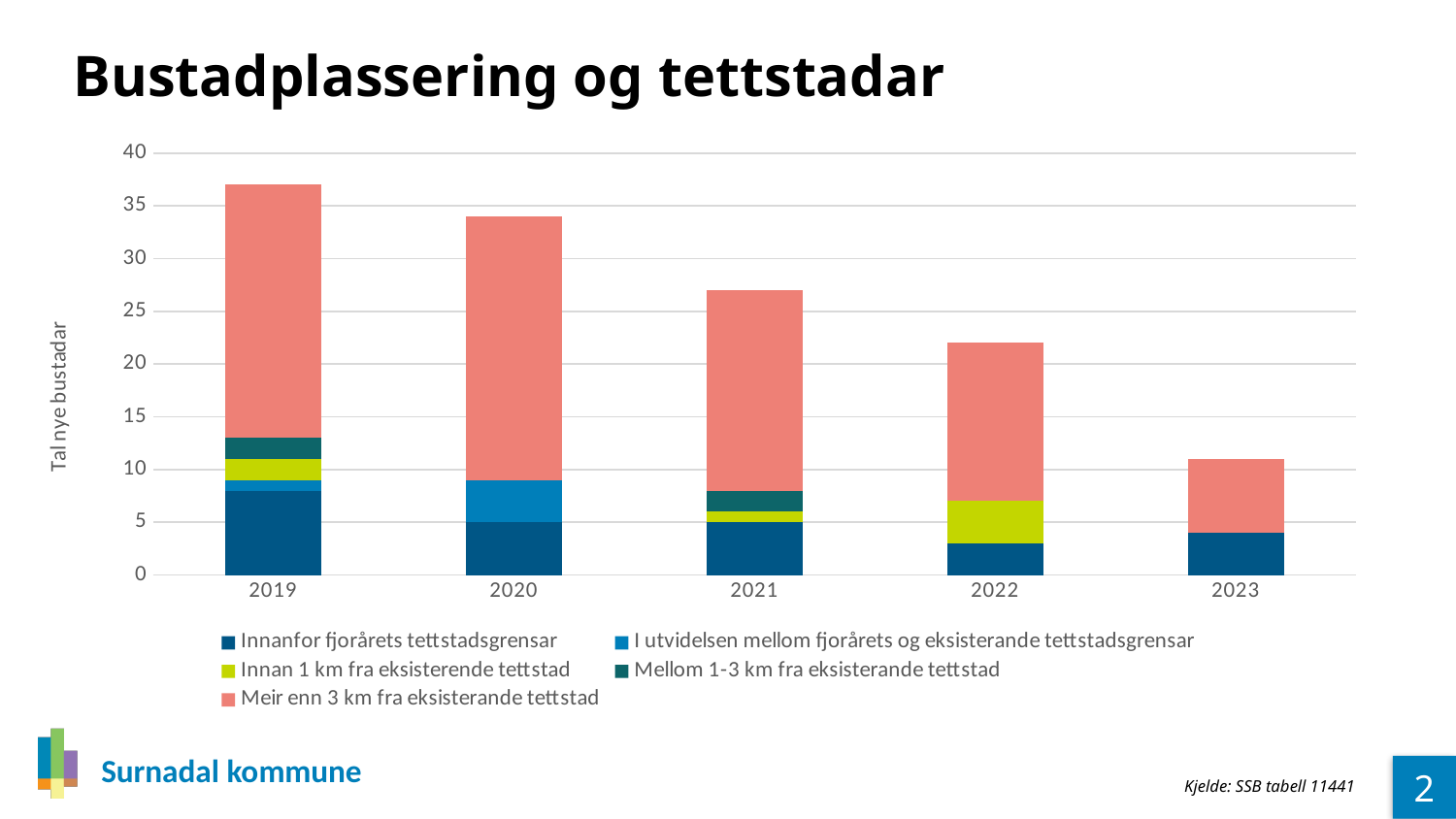
What is the label on the vertical axis of the chart? Tal nye bustadar Is the total bar height for 2023 greater or less than 15? less Which year has the tallest stacked bar? 2019 Which year has the taller stacked bar, 2020 or 2021? 2020 Which legend entry is shown in the salmon/red colour that forms the top segment of each bar? Meir enn 3 km fra eksisterande tettstad What kind of chart is shown on the slide? Stacked bar chart Is the total bar height for 2019 greater or less than 35? greater Do the total bar heights rise or fall from 2019 to 2023? Fall Which year has the shortest stacked bar? 2023 Is the total bar height for 2022 greater or less than 25? less How many series does the legend list? 5 How many years are shown on the x axis of the chart? 5